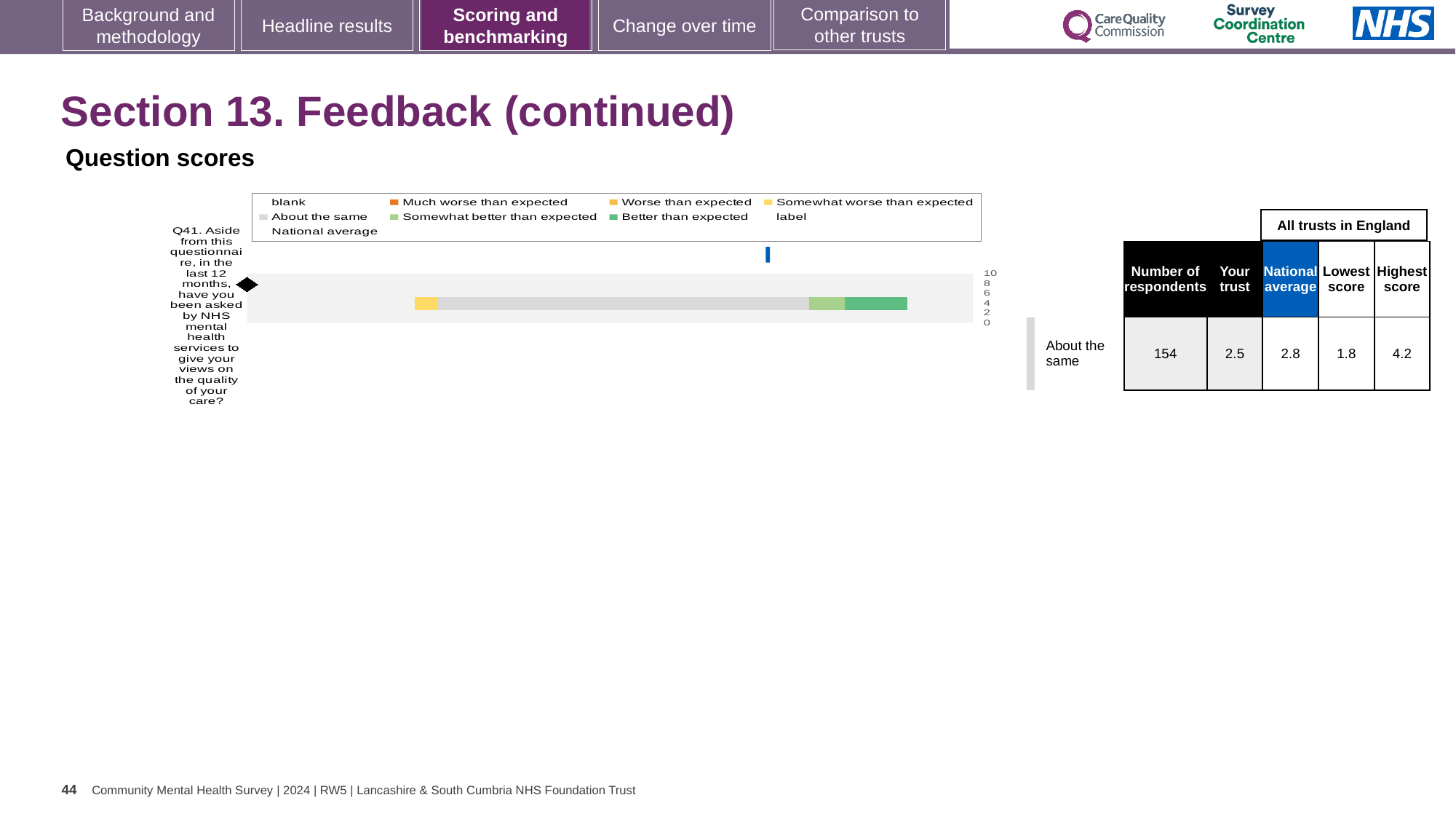
How many entries does the chart legend list? 9 How many respondents answered Q41 according to the table beside the chart? 154 How many survey questions are plotted in the chart? 1 What is the highest value shown on the chart's axis? 10 What kind of chart is used to show the Q41 question score? bar chart In the table beside the chart, what is the 'Your trust' score for Q41? 2.5 In the table beside the chart, what is the National average score for Q41? 2.8 What is the difference between the Highest score and the Lowest score for Q41 in the table beside the chart? 2.4 Which is larger for Q41, the 'Your trust' score or the National average score? National average In the table beside the chart, what is the Lowest score among all trusts in England for Q41? 1.8 Which question number is plotted in the chart? Q41 In the table beside the chart, what is the Highest score among all trusts in England for Q41? 4.2